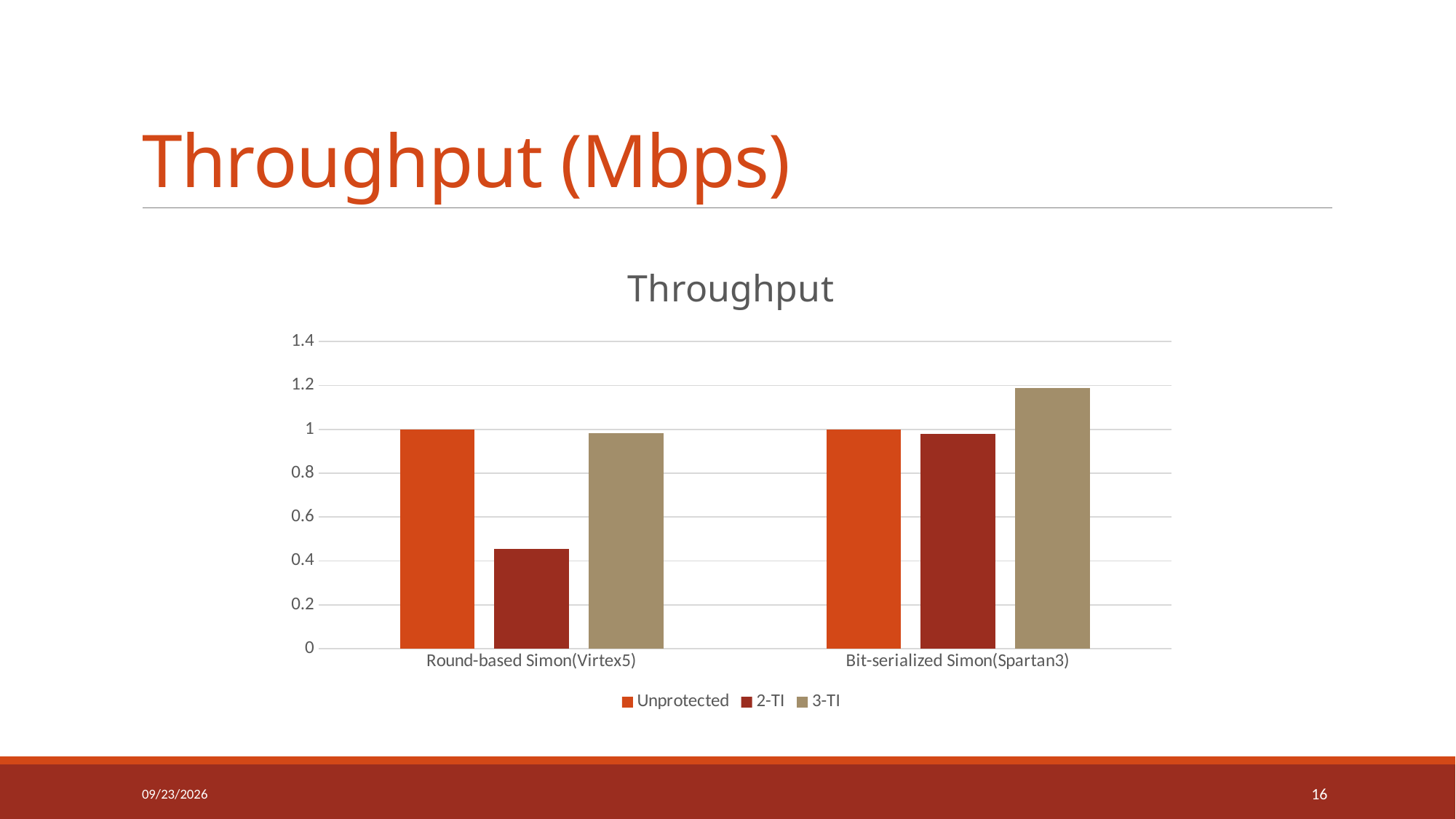
Is the 3-TI value for Bit-serialized Simon(Spartan3) greater or less than 1? greater Which series is shown in the lightest (tan) colour in the legend? 3-TI Which series has the highest value for Bit-serialized Simon(Spartan3)? 3-TI What kind of chart is shown on the slide? bar chart Which series has the lowest value for Round-based Simon(Virtex5)? 2-TI What is the Unprotected value for Round-based Simon(Virtex5)? 1 What is the title of the chart? Throughput How many series does the legend list? 3 Is the 2-TI value for Round-based Simon(Virtex5) greater or less than 0.6? less How many categories are shown on the x axis of the chart? 2 What is the Unprotected value for Bit-serialized Simon(Spartan3)? 1 Is the 2-TI value for Bit-serialized Simon(Spartan3) greater or less than 0.8? greater